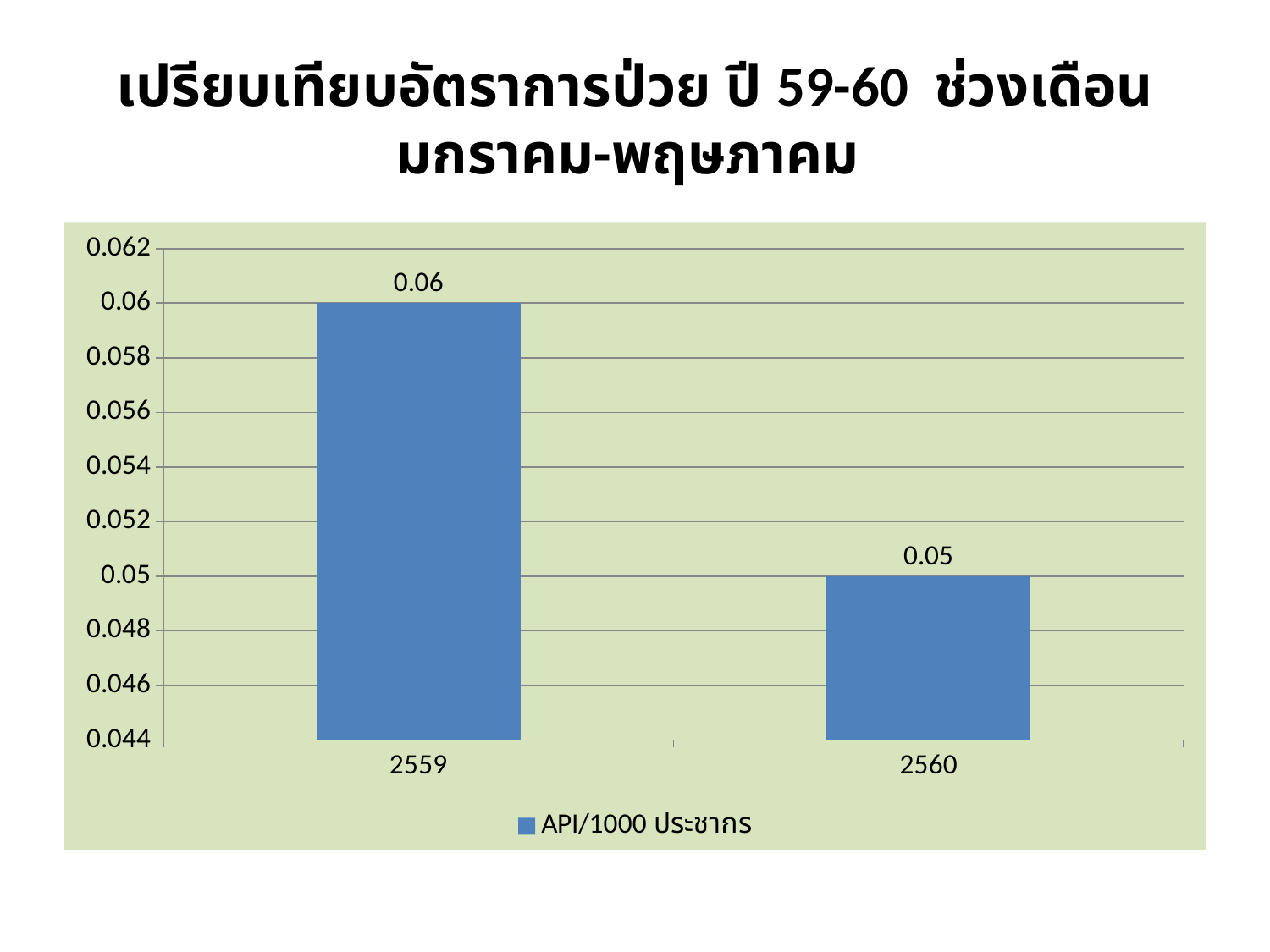
Which year has the highest value? 2559 Is the value for 2560 greater or less than 0.056? less What is the value for 2560? 0.05 Which is larger, the value for 2559 or the value for 2560? 2559 Which year has the lowest value? 2560 What is the difference between the values for 2559 and 2560? 0.01 What is the value for 2559? 0.06 What kind of chart is shown on the slide? bar chart Is the value for 2559 greater or less than 0.054? greater How many categories are shown on the x axis? 2 How many series does the legend list? 1 Do the values rise or fall from 2559 to 2560? fall